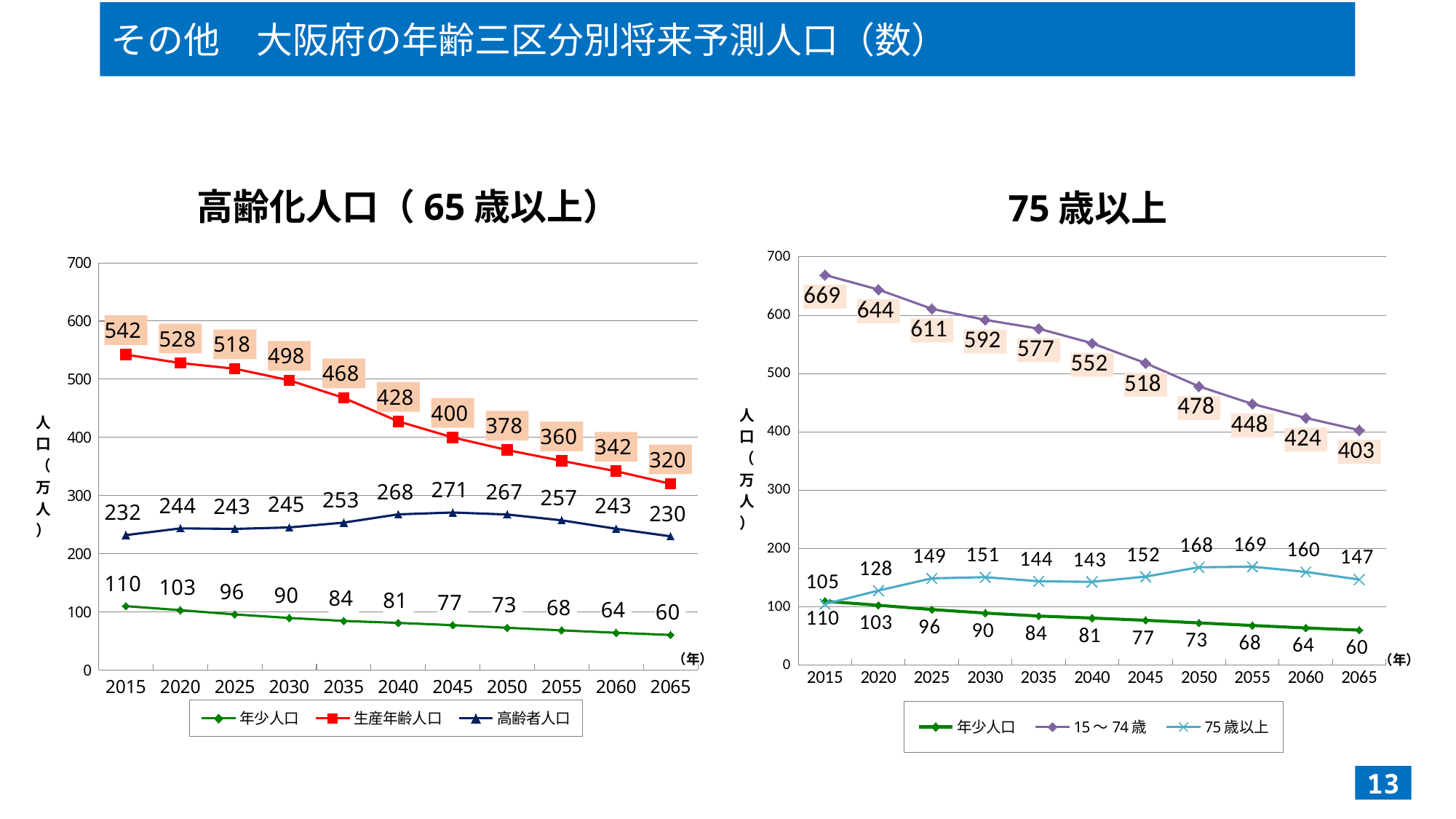
In the left chart (高齢化人口（65歳以上）), what is the value of 高齢者人口 in 2045? 271 In the left chart (高齢化人口（65歳以上）), what is the value of 生産年齢人口 in 2015? 542 What type of chart is the right chart (75歳以上)? line chart In the right chart (75歳以上), which is larger in 2065: 75歳以上 or 年少人口? 75歳以上 In the left chart (高齢化人口（65歳以上）), does 年少人口 rise or fall from 2015 to 2065? fall In the right chart (75歳以上), what is the value of 15～74歳 in 2030? 592 In the left chart (高齢化人口（65歳以上）), how many series does the legend list? 3 In the left chart (高齢化人口（65歳以上）), in which year does 高齢者人口 reach its highest value? 2045 In the left chart (高齢化人口（65歳以上）), what is the difference between 生産年齢人口 in 2015 and in 2065? 222 In the right chart (75歳以上), what is the value of 75歳以上 in 2055? 169 In the right chart (75歳以上), in which year is 75歳以上 at its lowest value? 2015 In the right chart (75歳以上), how many years are plotted on the x axis? 11